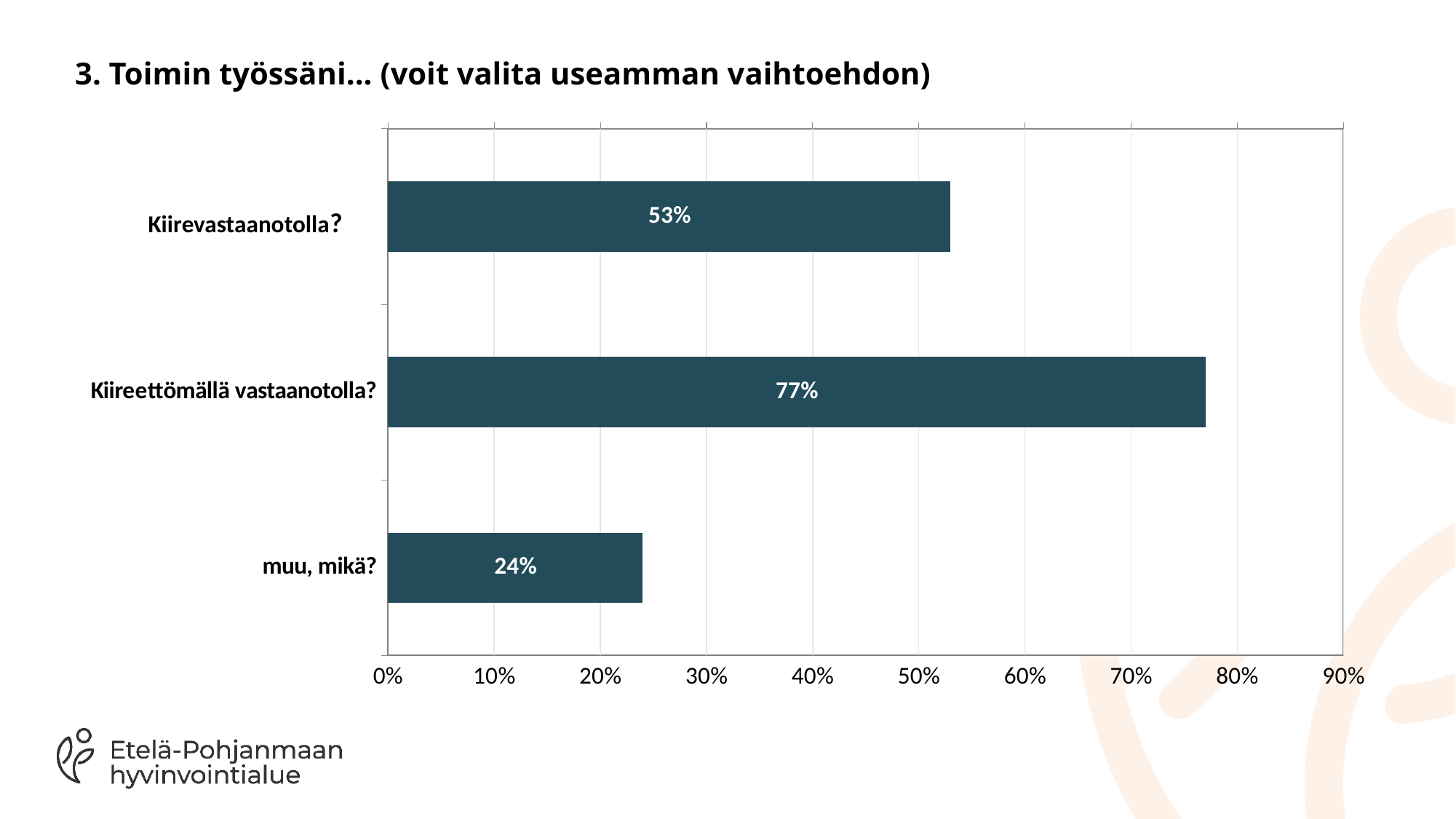
Which category has the lowest value? muu, mikä? What is the value for Kiireettömällä vastaanotolla? 77% Which category has the highest value? Kiireettömällä vastaanotolla? How many categories are shown in the chart? 3 Which is larger, the value for Kiirevastaanotolla or the value for muu, mikä? Kiirevastaanotolla? What is the title of the chart? 3. Toimin työssäni… (voit valita useamman vaihtoehdon) What is the value for Kiirevastaanotolla? 53% What kind of chart is shown on the slide? bar chart What is the difference between the values for Kiirevastaanotolla and muu, mikä? 29% What is the difference between the values for Kiireettömällä vastaanotolla and Kiirevastaanotolla? 24% What is the value for muu, mikä? 24% Is the value for Kiireettömällä vastaanotolla greater or less than 70%? greater